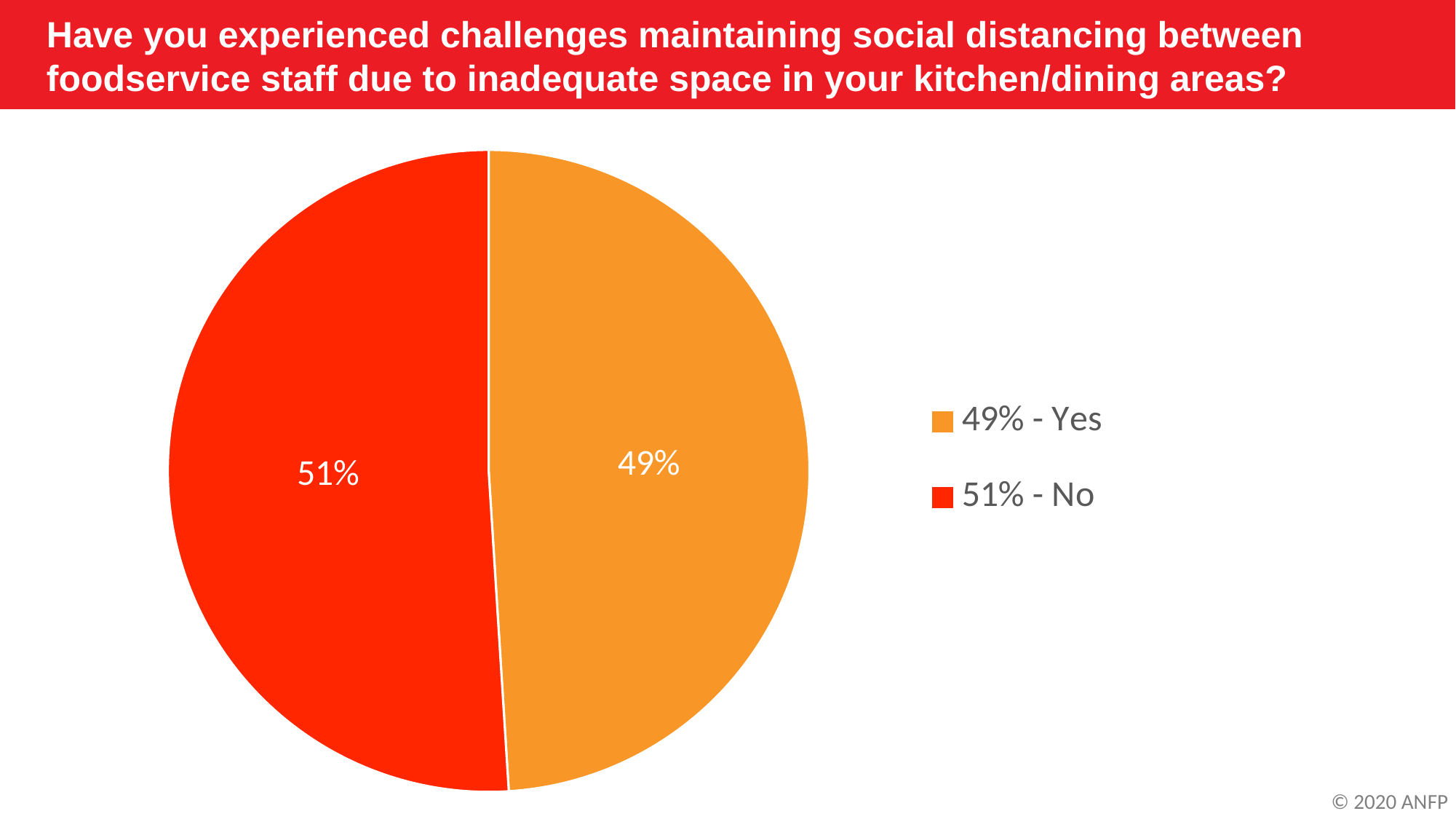
What percentage of respondents answered Yes? 49% What kind of chart is shown on the slide? pie chart How many entries does the legend list? 2 What is the total of the two slices shown in the pie chart? 100% How many slices does the pie chart have? 2 What is the difference in percentage points between the No and Yes responses? 2 Is the share for Yes larger or smaller than the share for No? smaller Which response has the smaller share of the pie? Yes What colour is the slice representing No? red What percentage of respondents answered No? 51% Which response has the larger share of the pie? No What colour is the slice representing Yes? orange